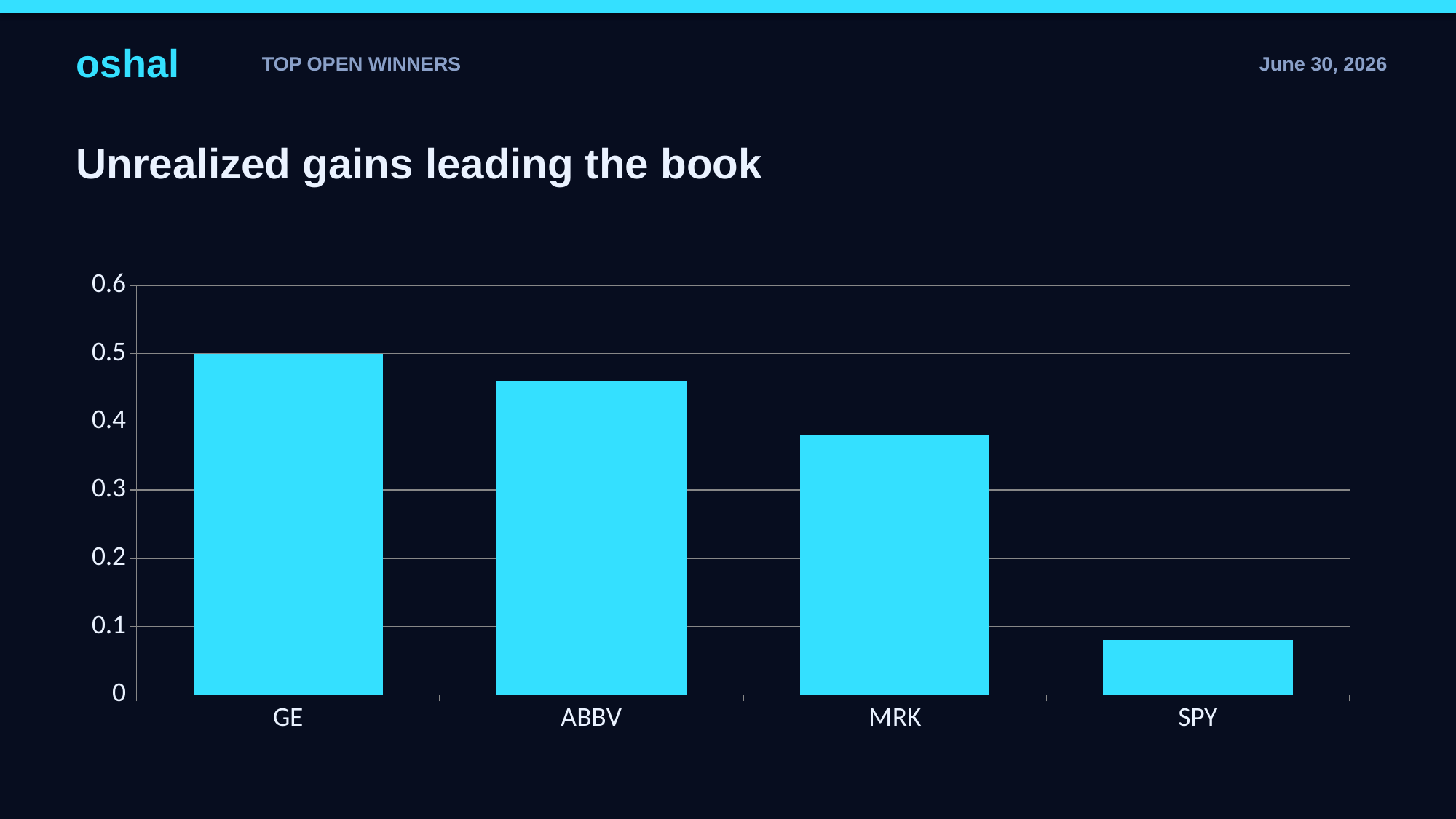
Is the value for ABBV greater or less than 0.4? greater What is the title of the chart on the slide? Unrealized gains leading the book What is the highest value shown on the y axis of the chart? 0.6 Which category has the lowest value in the chart? SPY Which category has the highest value in the chart? GE What kind of chart is shown on the slide? Bar chart Do the values rise or fall moving from left to right along the x axis? Fall Is the value for MRK greater or less than 0.4? less Is the value for SPY greater or less than 0.1? less What is the value for GE in the chart? 0.5 How many categories are shown on the x axis of the chart? 4 Which has the larger value, ABBV or MRK? ABBV